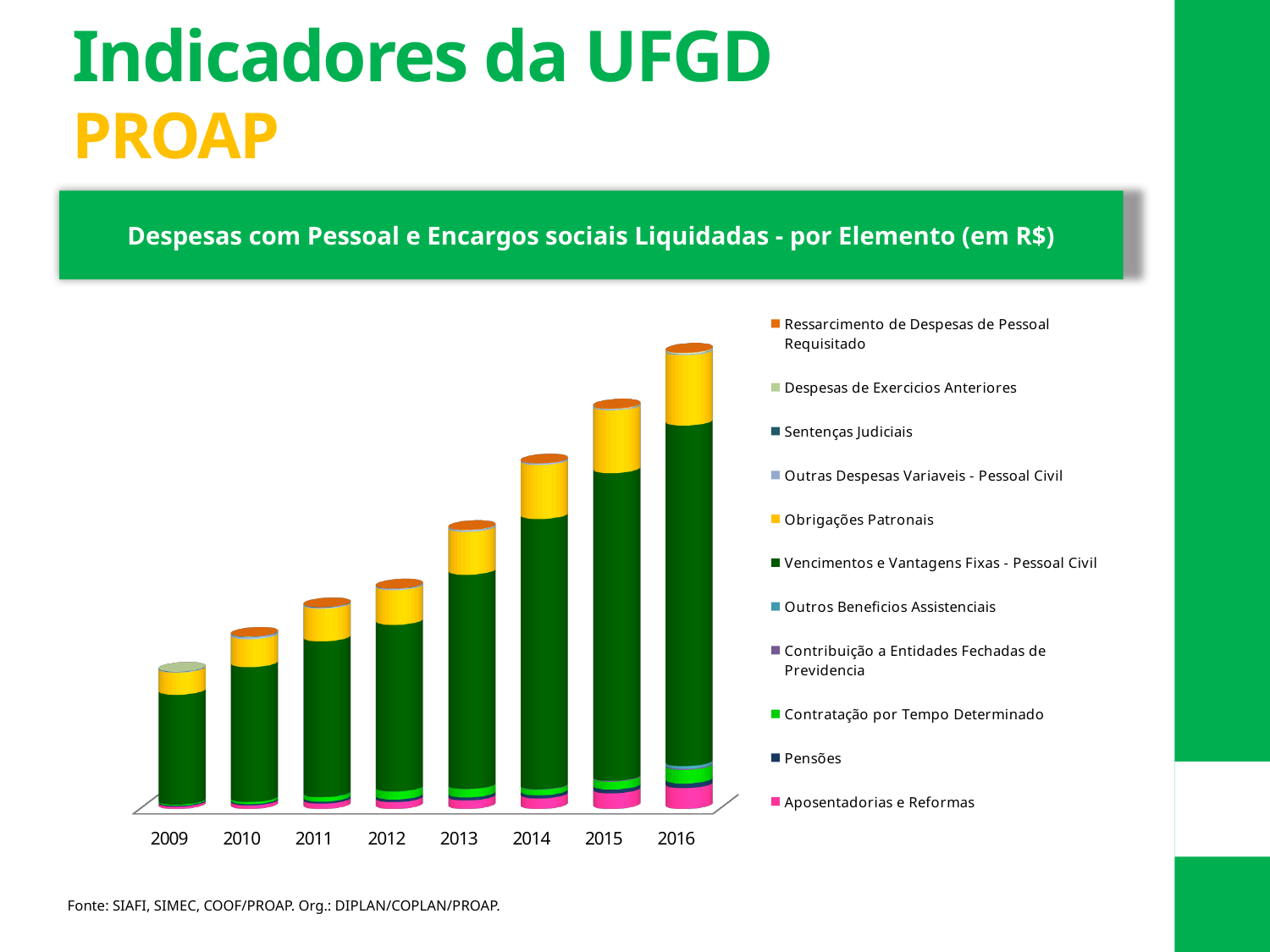
How many series does the chart's legend list? 11 Which year has the shortest stacked bar? 2009 Which year has the tallest stacked bar? 2016 What is the first year shown on the x axis? 2009 What is the title of the chart? Despesas com Pessoal e Encargos sociais Liquidadas - por Elemento (em R$) Do the total expenses rise or fall from 2009 to 2016? Rise What kind of chart is shown on the slide? Stacked bar chart Which year has the larger total bar, 2014 or 2015? 2015 Which series makes up the largest segment of each bar? Vencimentos e Vantagens Fixas - Pessoal Civil What colour represents Obrigações Patronais in the chart? Yellow How many years are shown along the x axis of the chart? 8 Which year has the larger total bar, 2012 or 2013? 2013